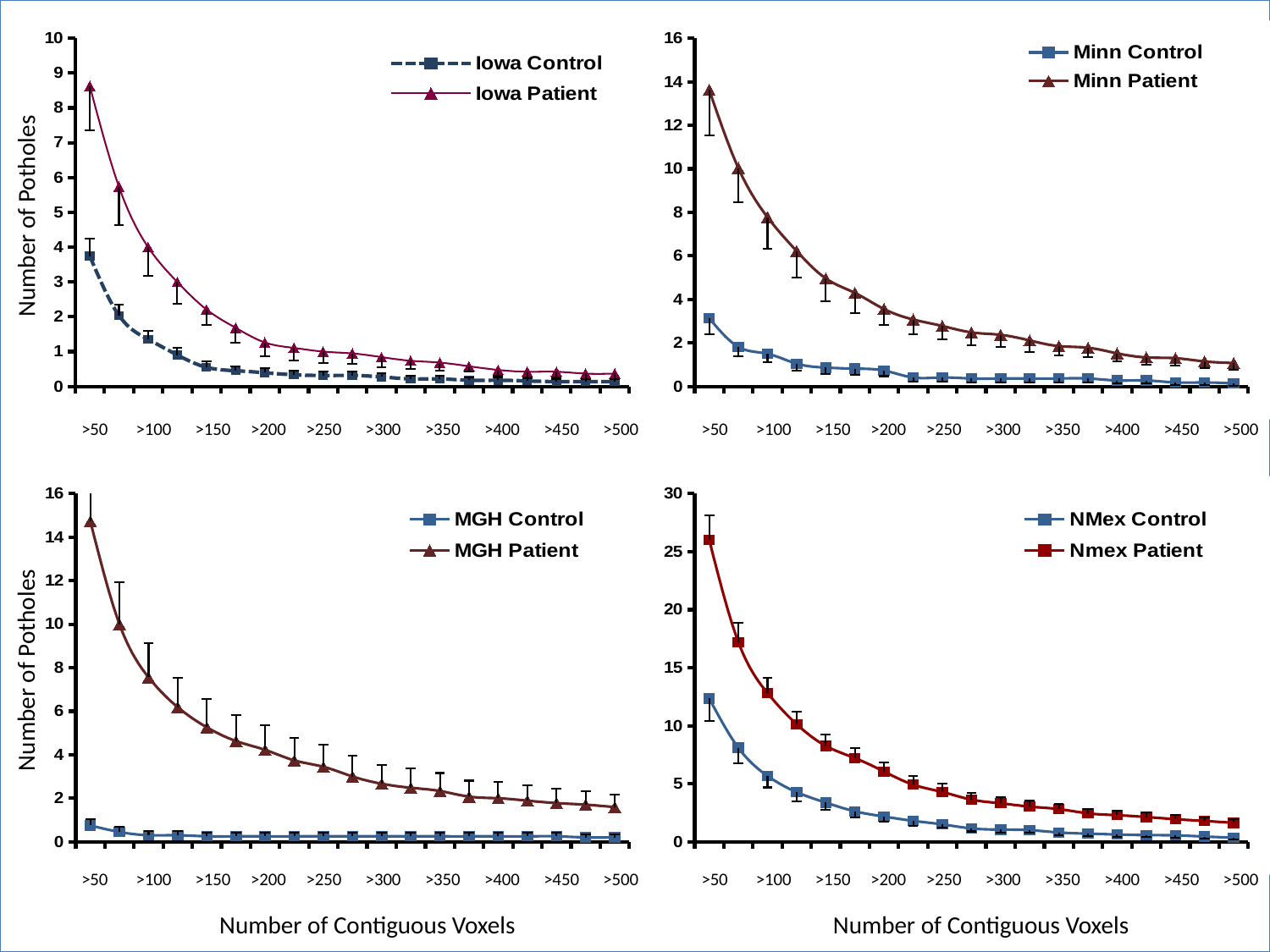
In the bottom-left chart (MGH), is the value for MGH Control at >50 greater or less than 2? less In the bottom-right chart (NMex), is the value for Nmex Patient at >50 greater or less than 20? greater How many series does the legend of the bottom-right chart (NMex) list? 2 In the top-right chart (Minn), do the values for Minn Patient rise or fall as the number of contiguous voxels increases? fall In the top-left chart (Iowa), which series is drawn with a dashed line? Iowa Control In the top-left chart (Iowa), is the value for Iowa Control at >50 greater or less than 3? greater What is the label of the y axis on the top-left chart (Iowa)? Number of Potholes In the bottom-left chart (MGH), which series has the larger value at >100, MGH Patient or MGH Control? MGH Patient What kind of chart is the top-left chart (Iowa Control / Iowa Patient)? line chart